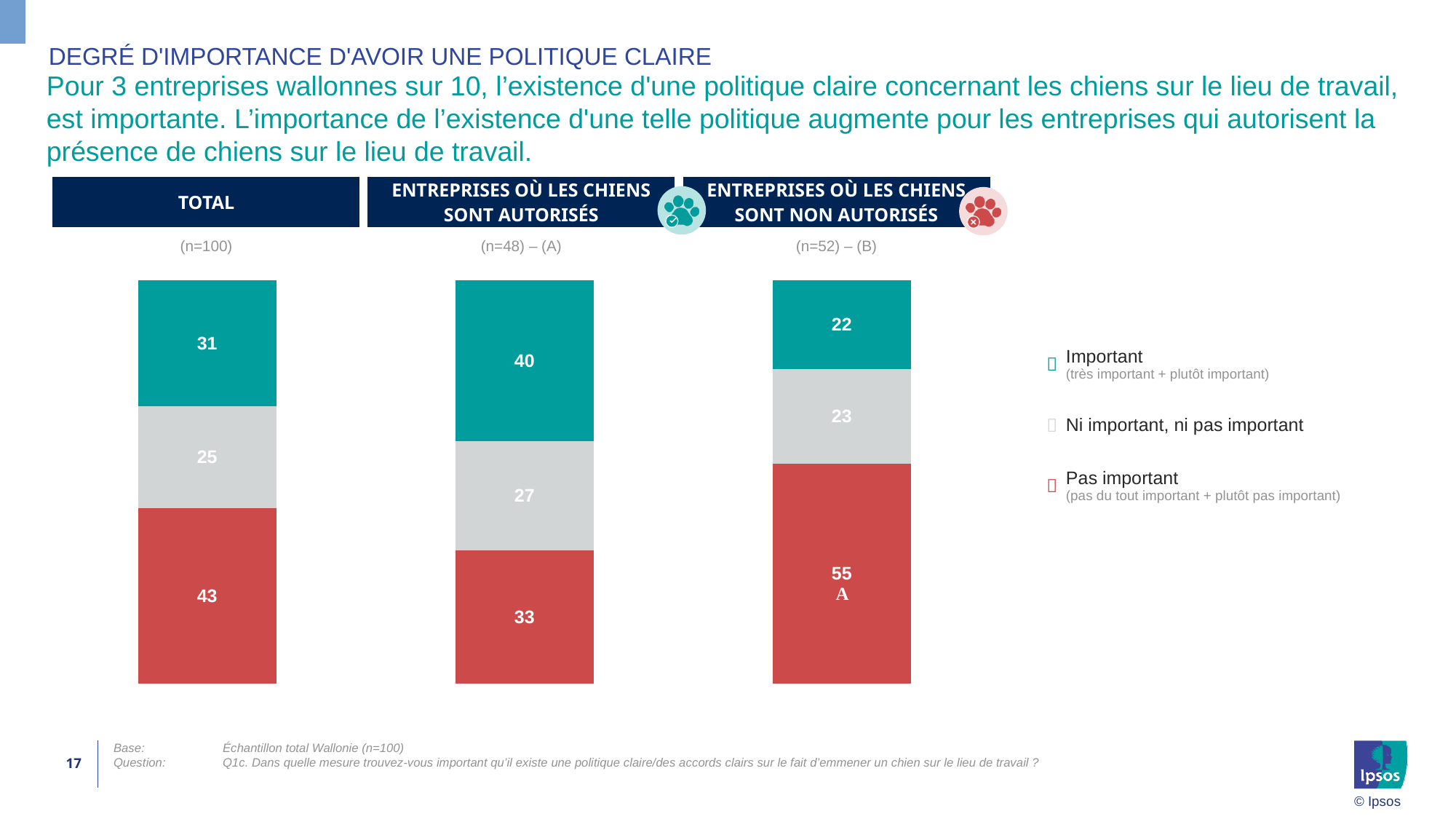
What is the value for "Ni important, ni pas important" in the bar for entreprises où les chiens sont autorisés? 27 What is the value for "Important" in the TOTAL bar? 31 How many bars are shown in the chart? 3 What is the sample size shown for the TOTAL bar? n=100 Is the "Important" value larger for entreprises où les chiens sont autorisés or for entreprises où les chiens sont non autorisés? Entreprises où les chiens sont autorisés Which group has the lowest value for "Pas important"? Entreprises où les chiens sont autorisés What is the total of the stacked bar for entreprises où les chiens sont non autorisés? 100 Which group has the highest value for "Important"? Entreprises où les chiens sont autorisés What is the difference between the "Pas important" values for entreprises où les chiens sont non autorisés and entreprises où les chiens sont autorisés? 22 What kind of chart is shown on the slide? Stacked bar chart How many series does the legend list? 3 What is the value for "Pas important" in the bar for entreprises où les chiens sont non autorisés? 55